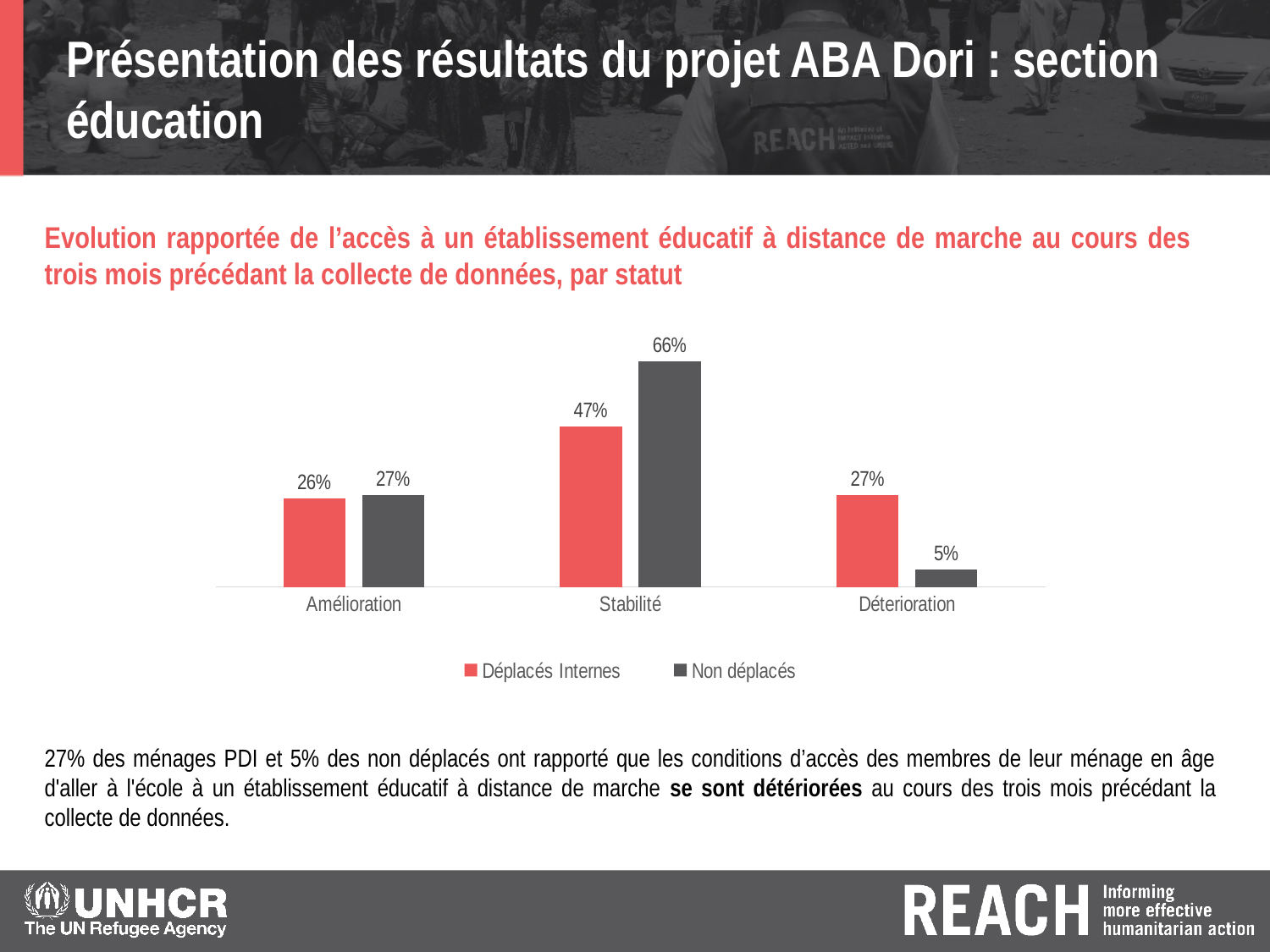
What is the value for Déplacés Internes in the Stabilité category? 47% How many series does the legend list? 2 What is the value for Non déplacés in the Amélioration category? 27% How many categories are shown on the x axis? 3 Which category has the highest value for Non déplacés? Stabilité What kind of chart is shown on the slide? Bar chart What is the difference between the Déplacés Internes and Non déplacés values in the Déterioration category? 22% Which category has the lowest value for Non déplacés? Déterioration What is the value for Non déplacés in the Déterioration category? 5% Which is larger in the Déterioration category: Déplacés Internes or Non déplacés? Déplacés Internes Which colour represents the Déplacés Internes series? Red What is the difference between the Non déplacés and Déplacés Internes values in the Stabilité category? 19%